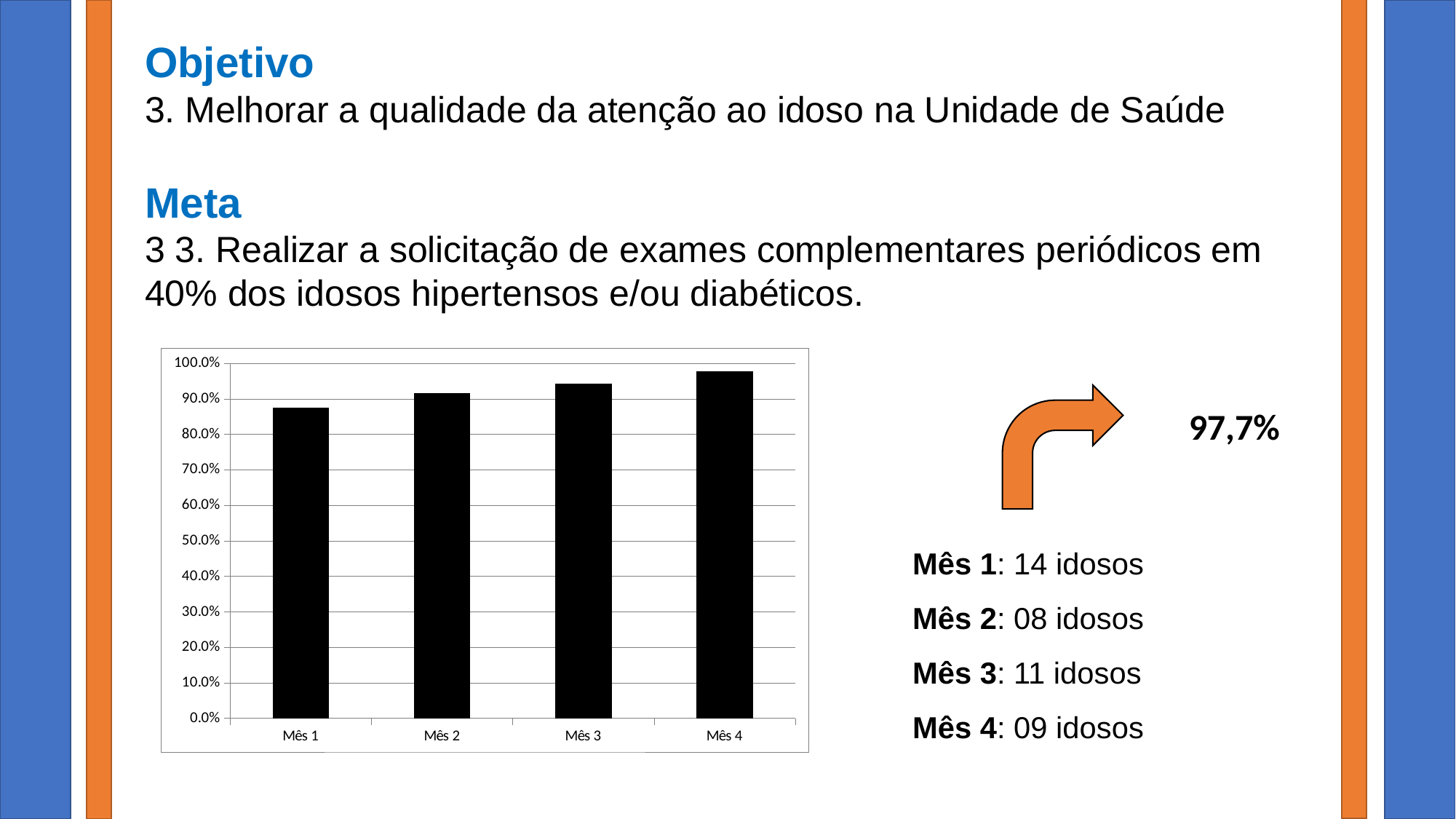
Which is larger, the value for Mês 2 or the value for Mês 4? Mês 4 Is the value for Mês 1 greater or less than 80%? greater Which month has the highest bar on the chart? Mês 4 Which month has the lowest bar on the chart? Mês 1 Is the value for Mês 4 greater or less than 100%? less Is the value for Mês 3 greater or less than 90%? greater Which is larger, the value for Mês 3 or the value for Mês 1? Mês 3 What kind of chart is shown on the slide? bar chart What is the label of the first category on the x axis? Mês 1 How many categories (months) are plotted on the chart? 4 Do the values rise or fall from Mês 1 to Mês 4? rise